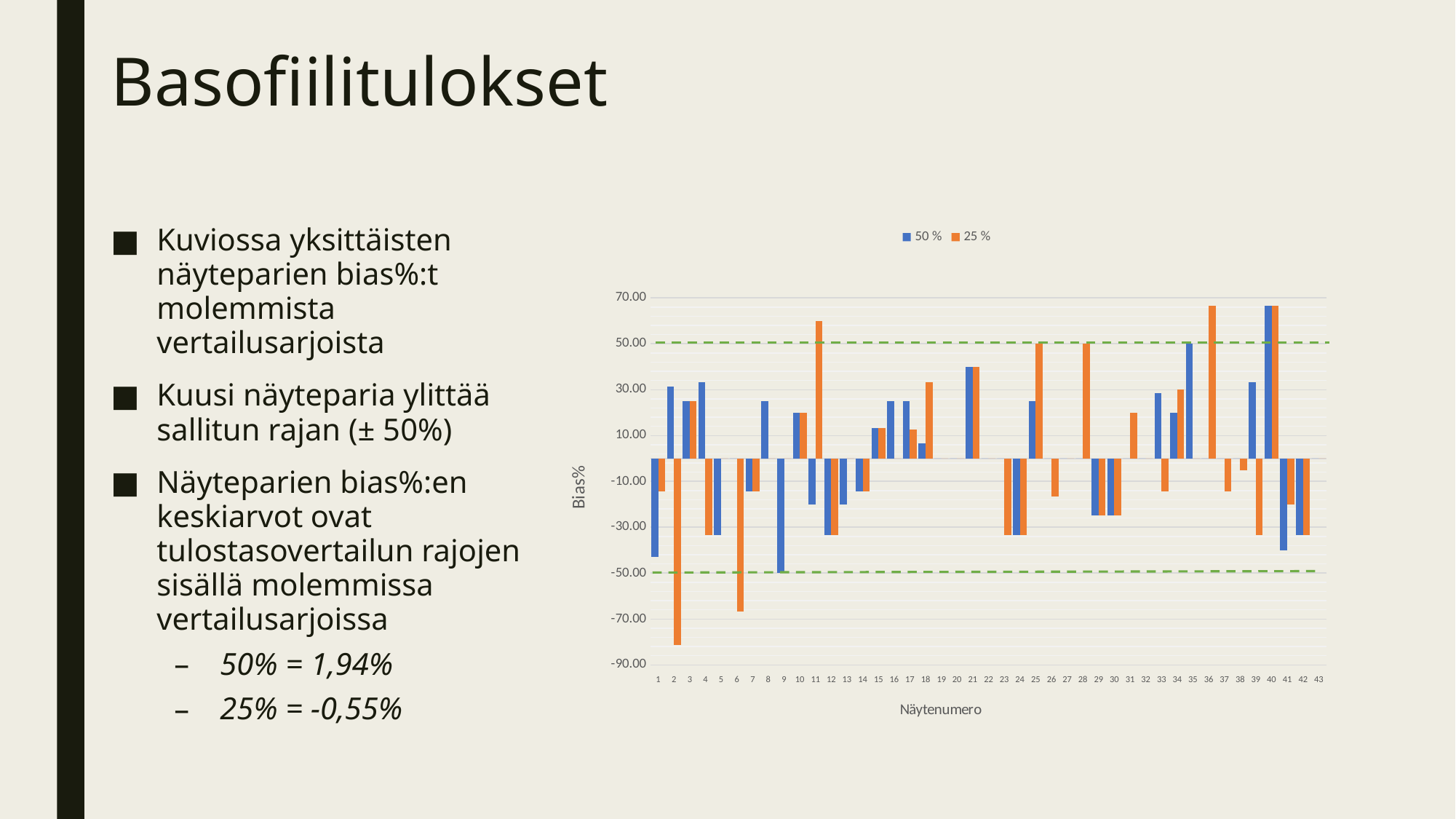
What kind of chart is shown on the slide? bar chart Is the 25 % value for sample 6 greater or less than -50? less Is the 25 % value for sample 11 greater or less than 50? greater For sample 11, which series has the larger value, 50 % or 25 %? 25 % Is the 50 % value for sample 40 greater or less than 50? greater How many series does the chart legend list? 2 What is the label of the chart's x axis? Näytenumero What are the two series named in the chart legend? 50 % and 25 % How many sample numbers (categories) are shown on the x axis? 43 Which sample number has the lowest value in the 25 % series? 2